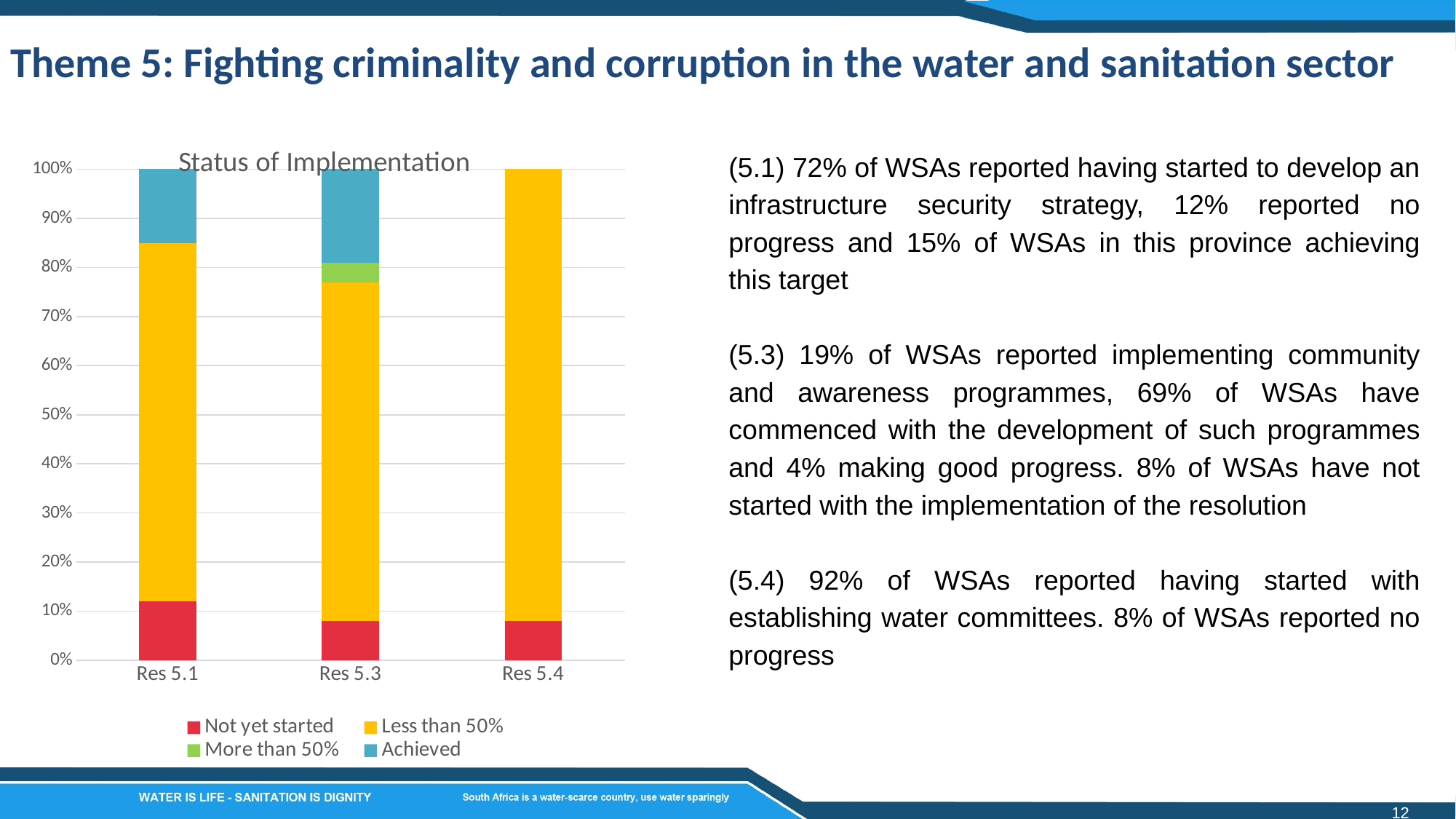
Is the 'Not yet started' value for Res 5.1 greater or less than 10%? greater Which category has the largest 'Less than 50%' segment? Res 5.4 What kind of chart is shown on the slide? Stacked bar chart Is the 'Not yet started' value for Res 5.3 greater or less than 10%? less What is the total of the stacked bar for Res 5.4? 100% Which category has the larger 'Not yet started' segment, Res 5.1 or Res 5.3? Res 5.1 Is the 'Less than 50%' value for Res 5.4 greater or less than 90%? greater How many categories are shown on the x axis of the chart? 3 What is the title of the chart? Status of Implementation How many series does the chart legend list? 4 Which category is the only one with a 'More than 50%' segment? Res 5.3